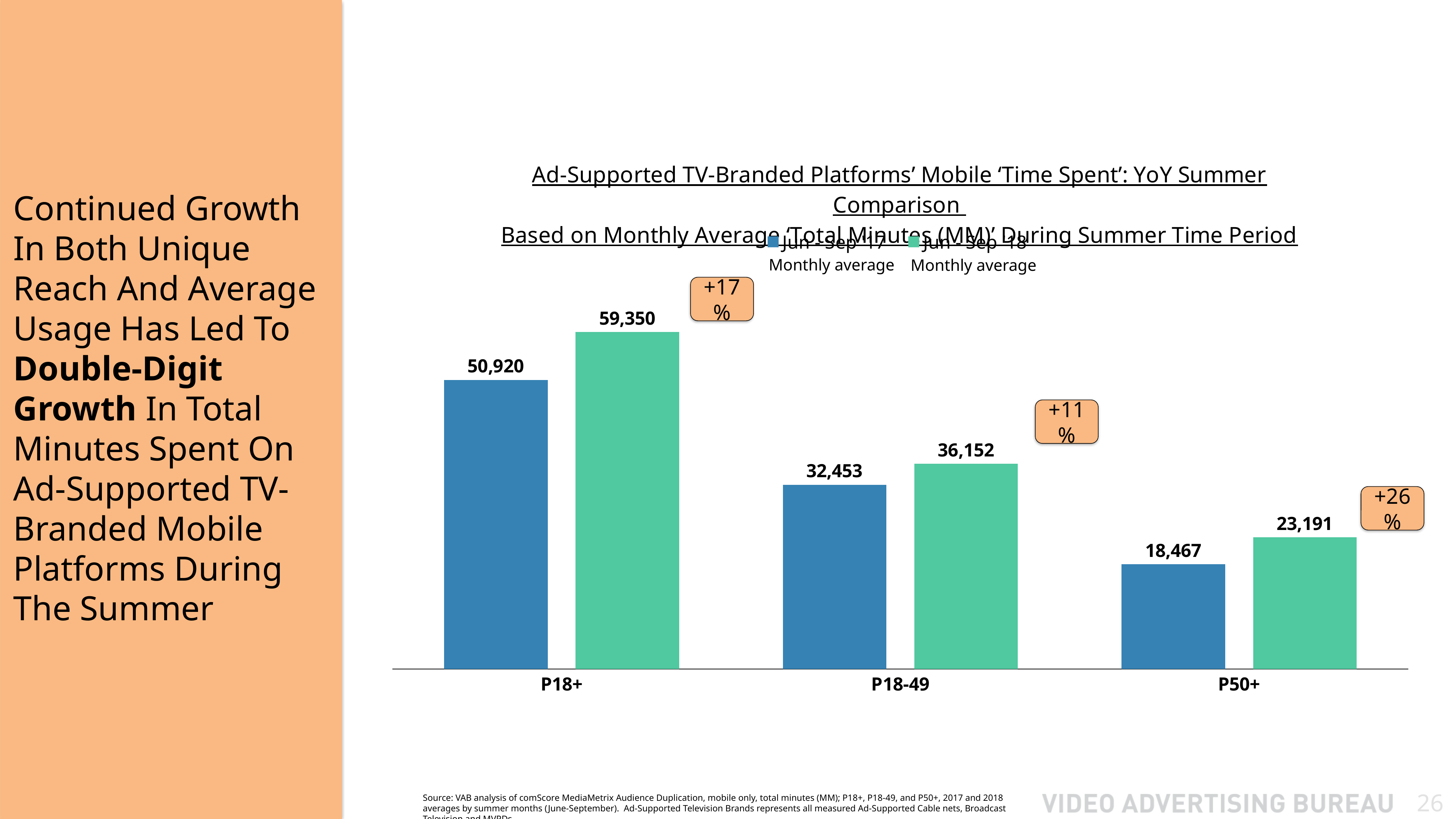
What is the Jun - Sep '18 monthly average value for P18-49? 36,152 What is the Jun - Sep '17 monthly average value for P50+? 18,467 How many audience categories are shown on the x axis? 3 Which category has the highest Jun - Sep '18 monthly average value? P18+ What is the Jun - Sep '17 monthly average value for P18+? 50,920 What is the difference between the Jun - Sep '18 and Jun - Sep '17 values for P50+? 4,724 What is the difference between the Jun - Sep '18 and Jun - Sep '17 values for P18+? 8,430 What percentage growth is shown in the callout for P50+? +26% Which category has the lowest Jun - Sep '17 monthly average value? P50+ What is the Jun - Sep '18 monthly average value for P18+? 59,350 How many series does the legend list? 2 Which is larger for P18-49: the Jun - Sep '17 value or the Jun - Sep '18 value? Jun - Sep '18